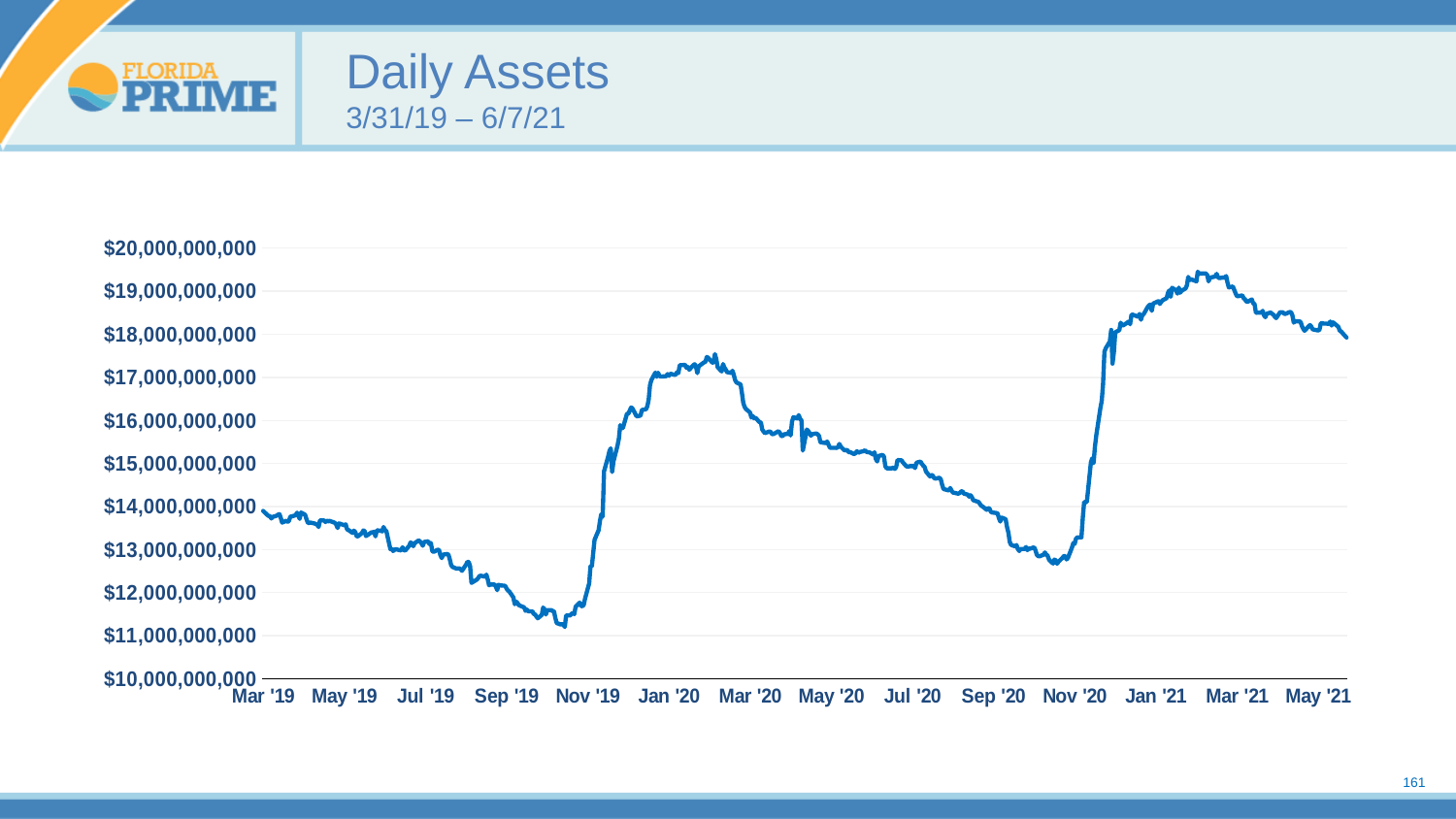
How many month labels are shown along the x axis? 14 Is the value at Jan '21 greater or less than $18,000,000,000? greater What date range does the chart subtitle give? 3/31/19 – 6/7/21 Is the value at May '20 greater or less than $15,000,000,000? greater Is the value at Nov '19 greater or less than $12,000,000,000? less What is the title of the chart on the slide? Daily Assets What kind of chart is shown on the slide? line chart Around which x-axis label does the line reach its lowest point? Nov '19 Do daily assets rise or fall between Mar '19 and Nov '19? fall Around which x-axis label does the line reach its highest point? Mar '21